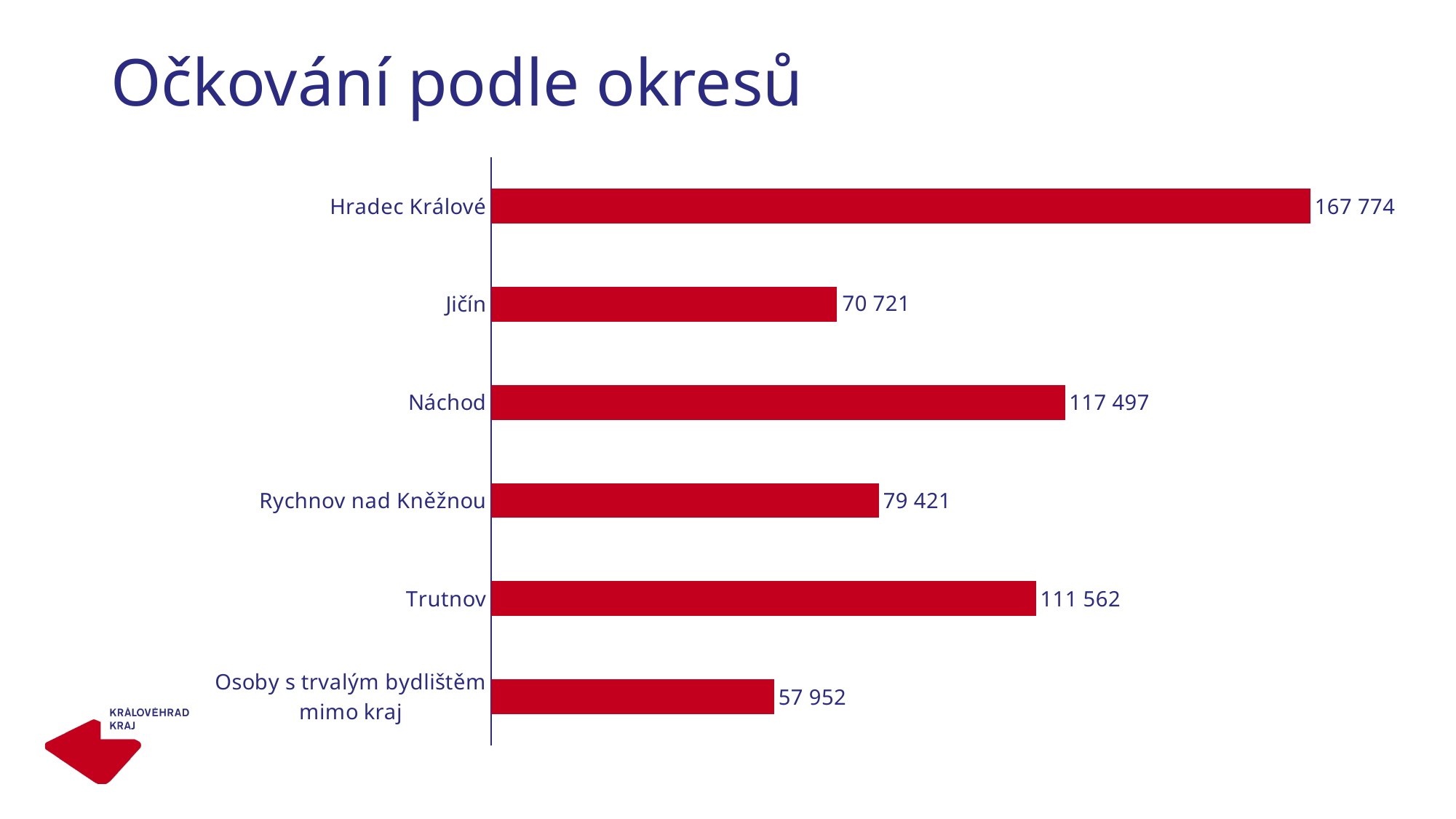
What is the value for Hradec Králové? 167 774 What is the value for Trutnov? 111 562 What is the value for Rychnov nad Kněžnou? 79 421 What is the difference between the values for Hradec Králové and Náchod? 50 277 How many categories are shown in the chart? 6 Which category has the highest value? Hradec Králové What is the value for Osoby s trvalým bydlištěm mimo kraj? 57 952 What is the value for Náchod? 117 497 Which is larger, the value for Náchod or the value for Trutnov? Náchod What kind of chart is shown on the slide? Bar chart What is the value for Jičín? 70 721 Which category has the lowest value? Osoby s trvalým bydlištěm mimo kraj